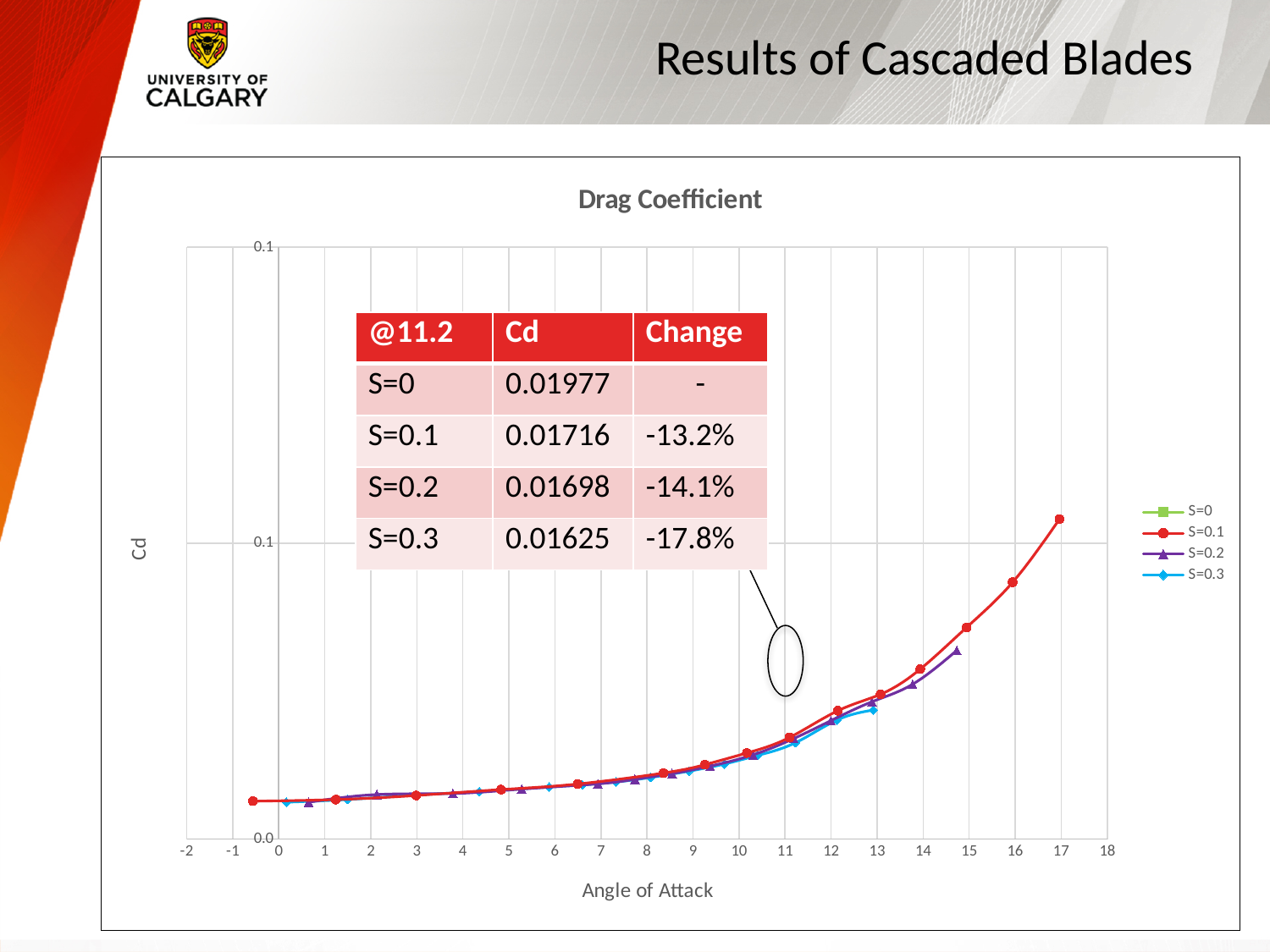
According to the table on the chart, what is the percentage change in Cd for S=0.2 at 11.2? -14.1% According to the table on the chart, which has the larger Cd at 11.2, S=0.1 or S=0.2? S=0.1 According to the table on the chart, which series has the lowest Cd at 11.2? S=0.3 What kind of chart is shown on the slide? line chart According to the table on the chart, what is the Cd value for S=0.3 at 11.2? 0.01625 According to the table on the chart, what is the Cd value for S=0 at an angle of attack of 11.2? 0.01977 How many series does the chart legend list? 4 What is the label of the x axis of the chart? Angle of Attack Does Cd rise or fall as the angle of attack increases along the x axis? rise According to the table on the chart, what is the difference between the Cd of S=0 and the Cd of S=0.3 at 11.2? 0.00352 What is the title of the chart? Drag Coefficient According to the table on the chart, which series has the highest Cd at 11.2? S=0